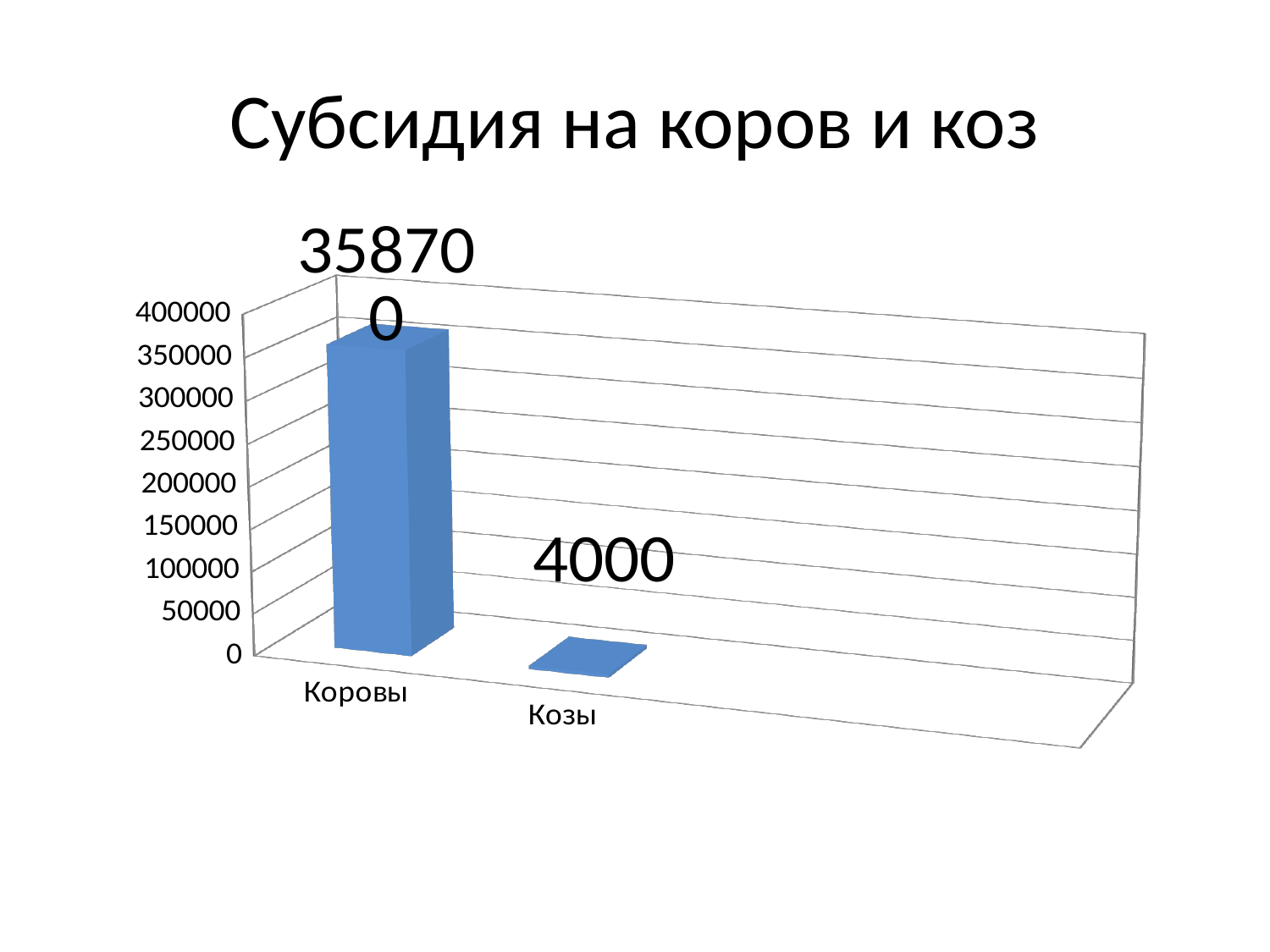
What is the value for Коровы? 358700 Is the value for Коровы greater or less than 300000? greater Is the value for Козы greater or less than 50000? less What is the value for Козы? 4000 Which is larger, the value for Коровы or the value for Козы? Коровы How many categories are shown on the chart? 2 What is the difference between the values for Коровы and Козы? 354700 Which category has the highest value? Коровы Which category has the lowest value? Козы What colour are the bars in the chart? blue What kind of chart is shown on the slide? bar chart What is the title of the slide? Субсидия на коров и коз